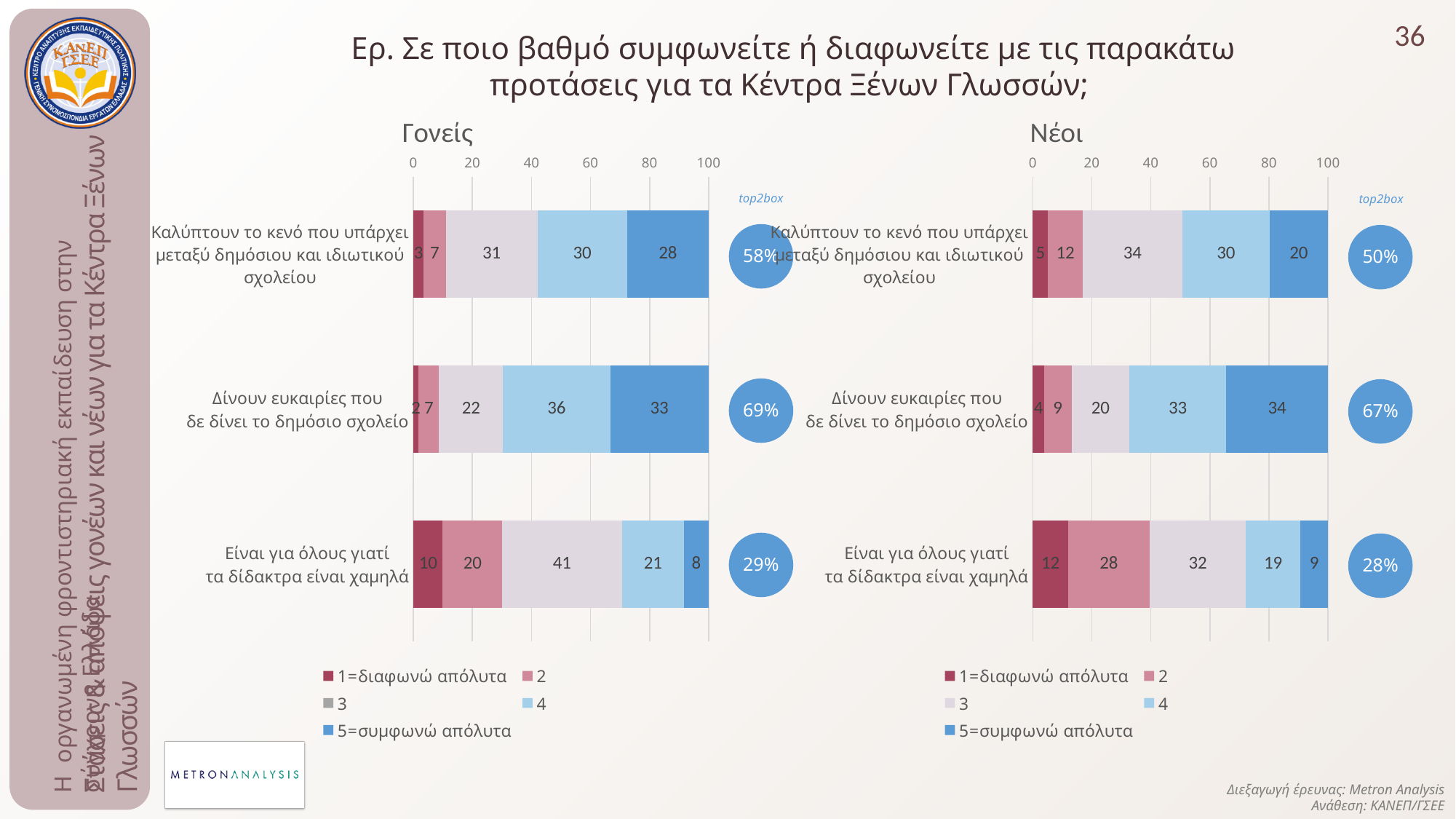
In the Γονείς chart, what is the value of the '1=διαφωνώ απόλυτα' segment for 'Είναι για όλους γιατί τα δίδακτρα είναι χαμηλά'? 10 In the Νέοι chart, which statement has the lowest top2box percentage? Είναι για όλους γιατί τα δίδακτρα είναι χαμηλά How many series does the legend of the Νέοι chart list? 5 How many statements (categories) are shown in the Γονείς chart? 3 What type of chart is the Γονείς chart? Stacked bar chart In the Νέοι chart, what is the value of the '3' segment for 'Καλύπτουν το κενό που υπάρχει μεταξύ δημόσιου και ιδιωτικού σχολείου'? 34 In the Νέοι chart, what is the top2box percentage shown for 'Δίνουν ευκαιρίες που δε δίνει το δημόσιο σχολείο'? 67% Is the '4' segment for 'Δίνουν ευκαιρίες που δε δίνει το δημόσιο σχολείο' larger in the Γονείς chart or the Νέοι chart? Γονείς In the Γονείς chart, which statement has the highest '5=συμφωνώ απόλυτα' value? Δίνουν ευκαιρίες που δε δίνει το δημόσιο σχολείο In the Νέοι chart, what is the difference between the '2' segment for 'Είναι για όλους γιατί τα δίδακτρα είναι χαμηλά' and the '2' segment for 'Δίνουν ευκαιρίες που δε δίνει το δημόσιο σχολείο'? 19 In the Γονείς chart, what is the value of the '5=συμφωνώ απόλυτα' segment for 'Δίνουν ευκαιρίες που δε δίνει το δημόσιο σχολείο'? 33 In the Γονείς chart, what is the total of the stacked bar for 'Είναι για όλους γιατί τα δίδακτρα είναι χαμηλά'? 100